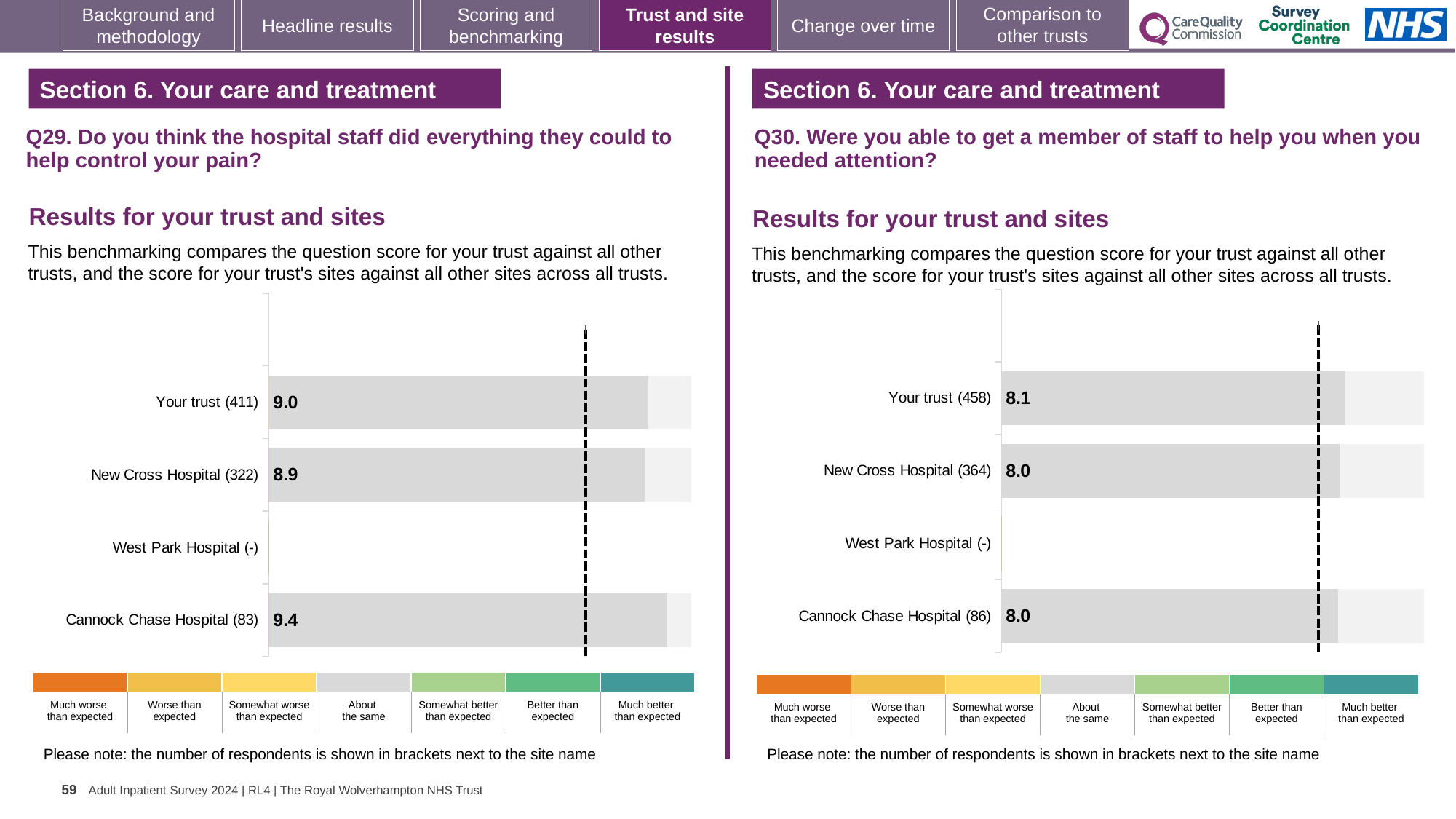
How many rows (sites or trust) are listed on the Q30 chart (right)? 4 On the Q29 chart (left), which site or trust has the highest score? Cannock Chase Hospital (83) On the Q29 chart (left), which has the higher score, Your trust (411) or New Cross Hospital (322)? Your trust (411) On the Q30 chart (right), what is the score for Your trust (458)? 8.1 What type of chart is used on the Q29 chart (left)? Bar chart On the Q30 chart (right), how many respondents are shown in brackets for West Park Hospital? - On the Q30 chart (right), what is the score for New Cross Hospital (364)? 8.0 On the Q29 chart (left), what is the difference between the scores for Cannock Chase Hospital (83) and New Cross Hospital (322)? 0.5 On the Q29 chart (left), what is the score for Your trust (411)? 9.0 On the Q29 chart (left), what is the score for Cannock Chase Hospital (83)? 9.4 On the Q30 chart (right), what is the difference between the scores for Your trust (458) and Cannock Chase Hospital (86)? 0.1 How many categories does the colour key below the Q29 chart (left) list? 7